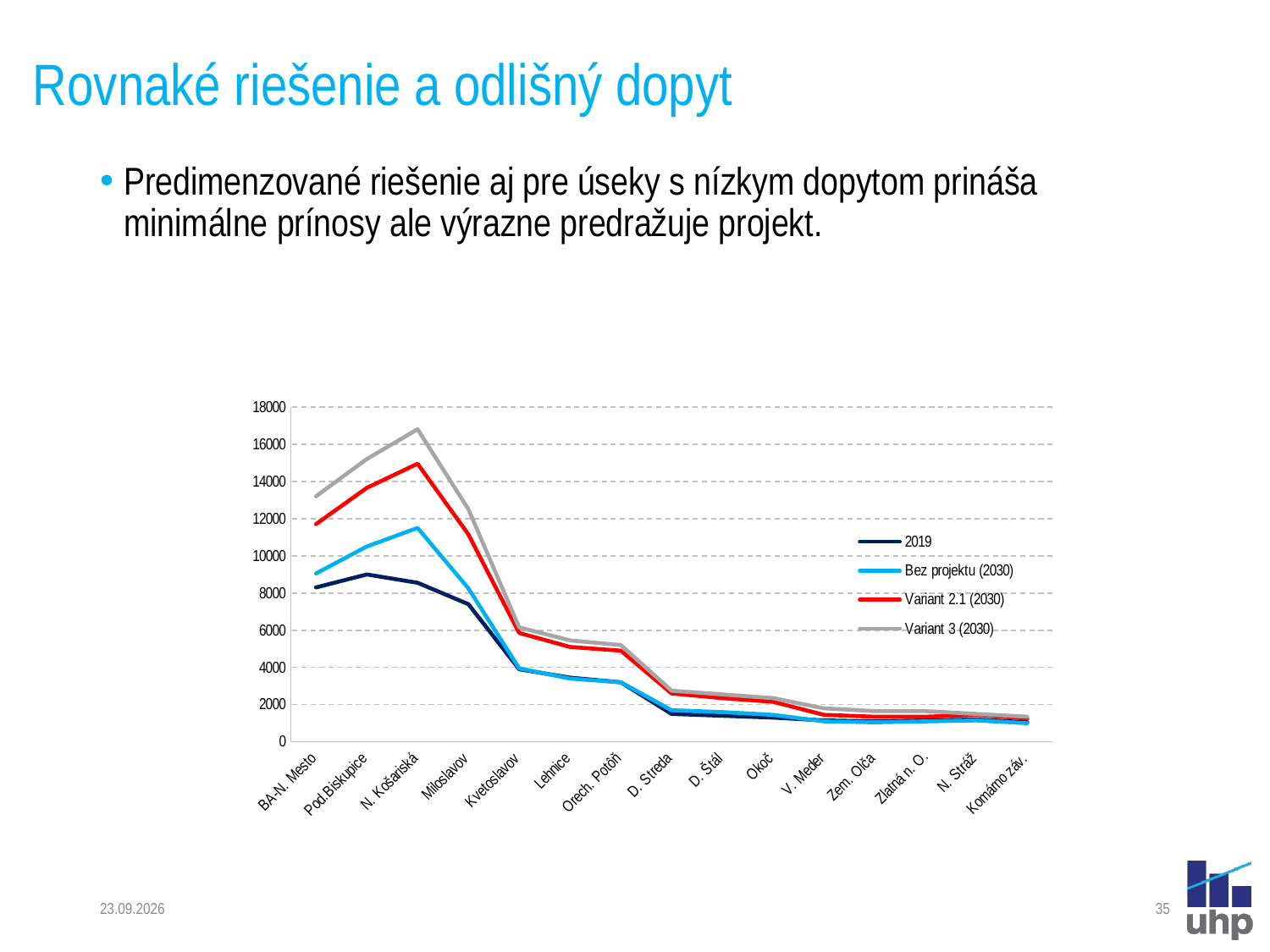
Is the value for Bez projektu (2030) at N. Košarská greater or less than 10000? greater Is the value for Variant 2.1 (2030) at N. Košarská greater or less than 14000? greater Is the value for Variant 3 (2030) at N. Košarská greater or less than 16000? greater At Pod.Biskupice, which is larger: the value for Variant 3 (2030) or the value for 2019? Variant 3 (2030) What kind of chart is shown on the slide? line chart How many categories are shown along the x axis of the chart? 15 For the Variant 3 (2030) series, which category has the highest value? N. Košariská What colour is the line for Variant 2.1 (2030) in the chart? red Do the values of the Variant 3 (2030) series generally rise or fall from Miloslavov to Komárno záv.? fall Which series has the highest value at N. Košarská? Variant 3 (2030) How many series does the chart legend list? 4